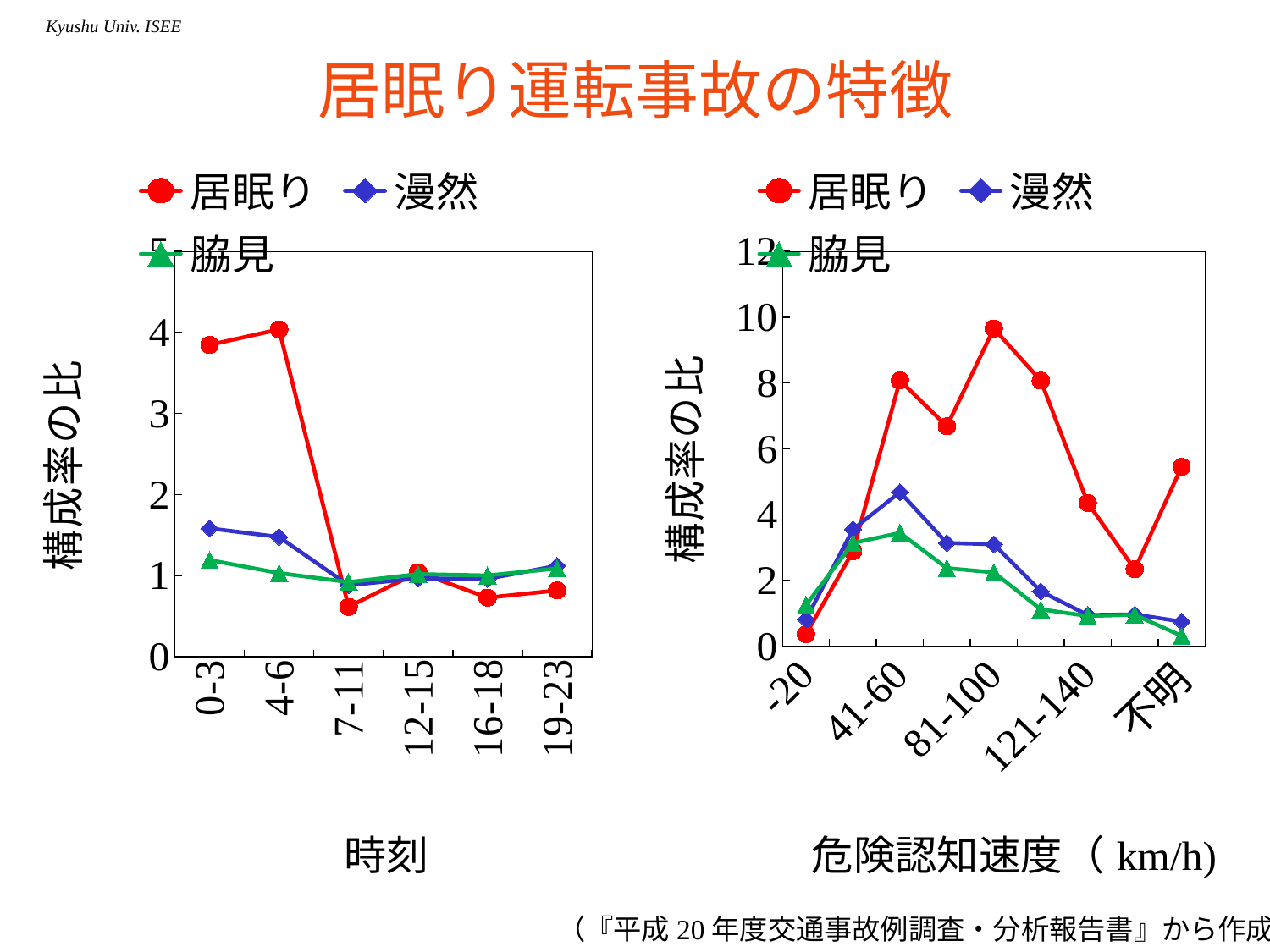
In the right chart (危険認知速度), is the value for 居眠り at 81-100 greater or less than 8? greater In the right chart (危険認知速度), which labelled speed category has the highest value for 居眠り? 81-100 In the left chart (時刻), which time slot has the highest value for 居眠り? 4-6 What is the y-axis label of the right chart? 構成率の比 In the left chart (時刻), is the value for 居眠り at 7-11 greater or less than 1? less In the right chart (危険認知速度), at 41-60, which is larger, 漫然 or 脇見? 漫然 In the left chart (時刻), which series has the highest value at 0-3? 居眠り How many series does the legend of the left chart (時刻) list? 3 In the left chart (時刻), is the value for 居眠り at 0-3 greater or less than 3? greater How many time categories are shown on the x axis of the left chart (時刻)? 6 What kind of chart is the left chart (時刻)? line chart In the left chart (時刻), does the 居眠り line rise or fall from 4-6 to 7-11? fall